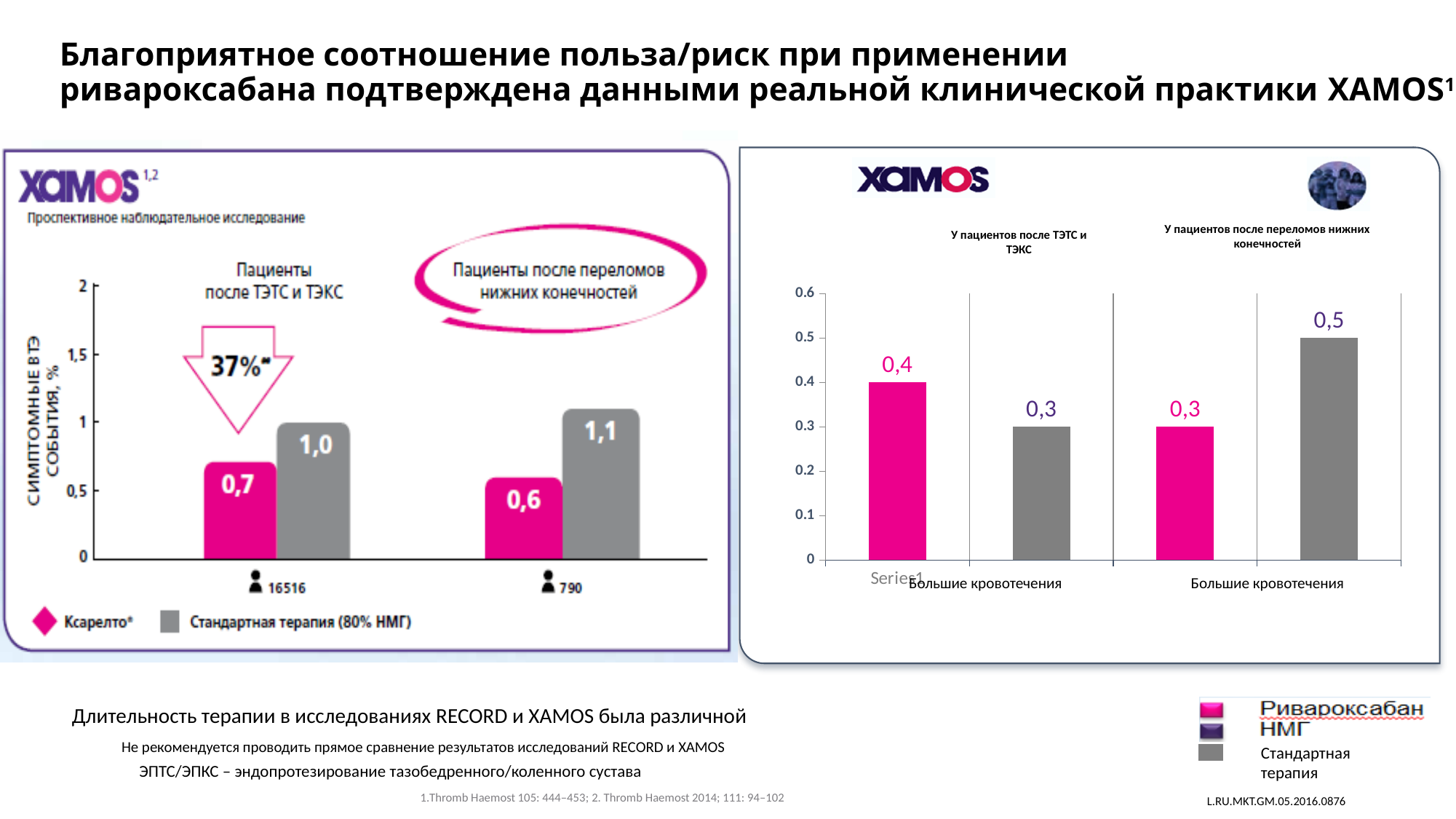
On the left chart (symptomatic VTE events), what is the difference between Стандартная терапия and Ксарелто in patients after ТЭТС и ТЭКС? 0,3 On the right chart (Большие кровотечения), which bar is the lowest? The grey bar for ТЭТС и ТЭКС and the pink bar for lower-limb fractures are both 0,3 On the right chart (Большие кровотечения), what is the value of the pink bar for patients after ТЭТС и ТЭКС? 0,4 On the left chart (symptomatic VTE events), what is the value for Ксарелто in patients after ТЭТС и ТЭКС? 0,7 On the left chart (symptomatic VTE events), what is the value for Стандартная терапия in patients after lower-limb fractures? 1,1 On the left chart (symptomatic VTE events), how many patients are shown for the ТЭТС и ТЭКС group? 16516 On the right chart (Большие кровотечения), what is the difference between the grey and pink bars for patients after lower-limb fractures? 0,2 On the right chart (Большие кровотечения), what is the value of the grey bar for patients after lower-limb fractures? 0,5 On the left chart (symptomatic VTE events), what percentage reduction is shown by the arrow for patients after ТЭТС и ТЭКС? 37% What type of chart is the right chart (Большие кровотечения)? Bar chart On the left chart (symptomatic VTE events), which bar is the highest? Стандартная терапия, patients after lower-limb fractures (1,1) On the right chart (Большие кровотечения), is the pink bar or the grey bar larger for patients after lower-limb fractures? Grey bar (0,5)